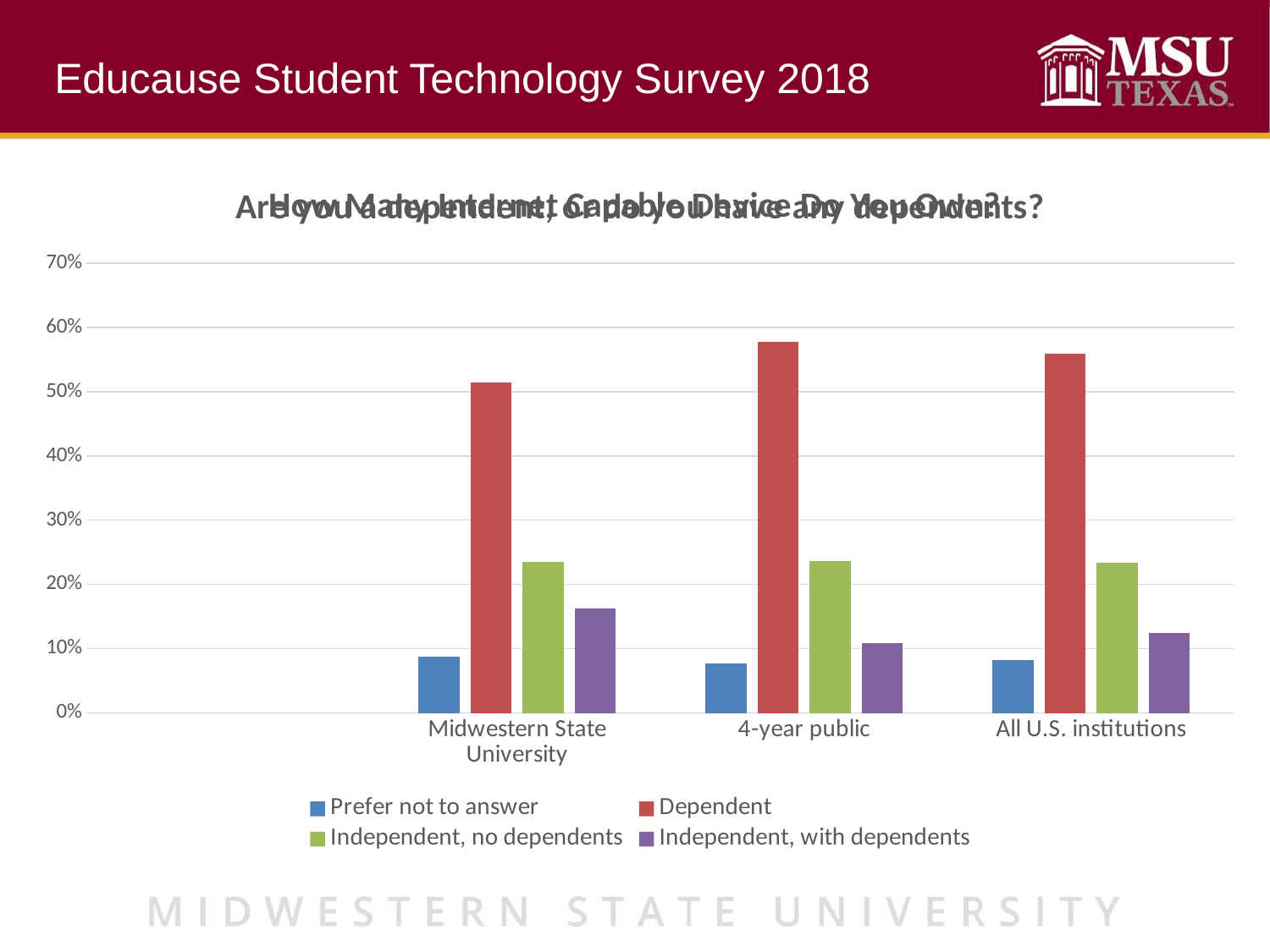
Is the Dependent value for 4-year public greater or less than 50%? greater Is the Prefer not to answer value for 4-year public greater or less than 10%? less How many categories are shown on the x axis of the chart? 3 Which is larger: the Dependent value for Midwestern State University or for 4-year public? 4-year public Which series has the highest value for Midwestern State University? Dependent Is the Independent, with dependents value for Midwestern State University greater or less than 10%? greater Which series has the lowest value for 4-year public? Prefer not to answer Which colour represents the Dependent series in the chart? red What kind of chart is shown on the slide? bar chart How many series does the chart's legend list? 4 Which category has the highest value for the Dependent series? 4-year public